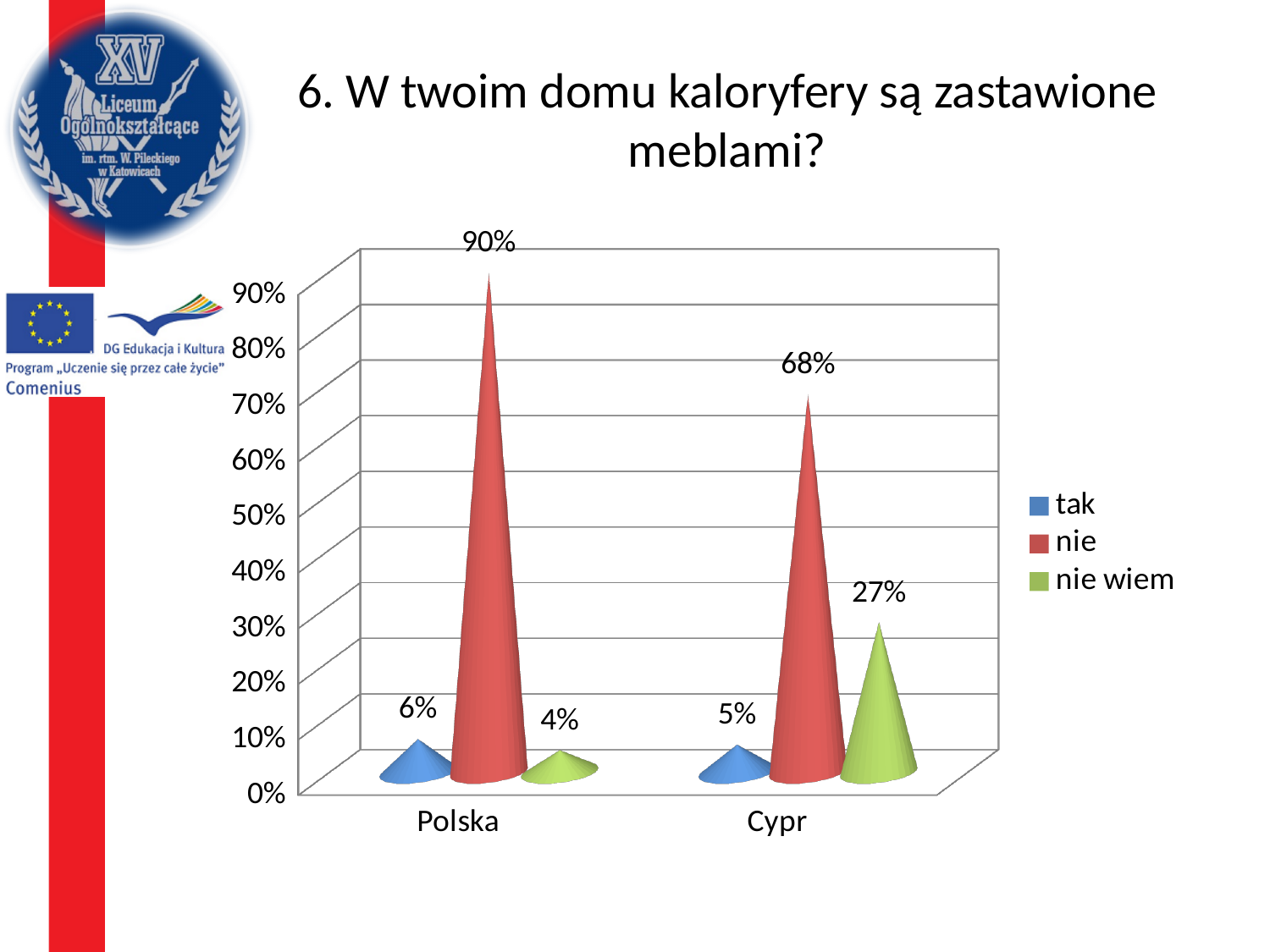
What is the value for "nie" for Polska? 90% Which is larger: "nie wiem" for Polska or "nie wiem" for Cypr? Cypr What is the difference between the "nie" values for Polska and Cypr? 22% How many categories are shown on the x axis? 2 What is the value for "tak" for Polska? 6% Which series has the highest value for Cypr? nie What is the value for "nie wiem" for Cypr? 27% What is the value for "tak" for Cypr? 5% How many series does the legend list? 3 What colour represents the "nie" series in the legend? red Which series has the lowest value for Polska? nie wiem What kind of chart is shown on the slide? bar chart